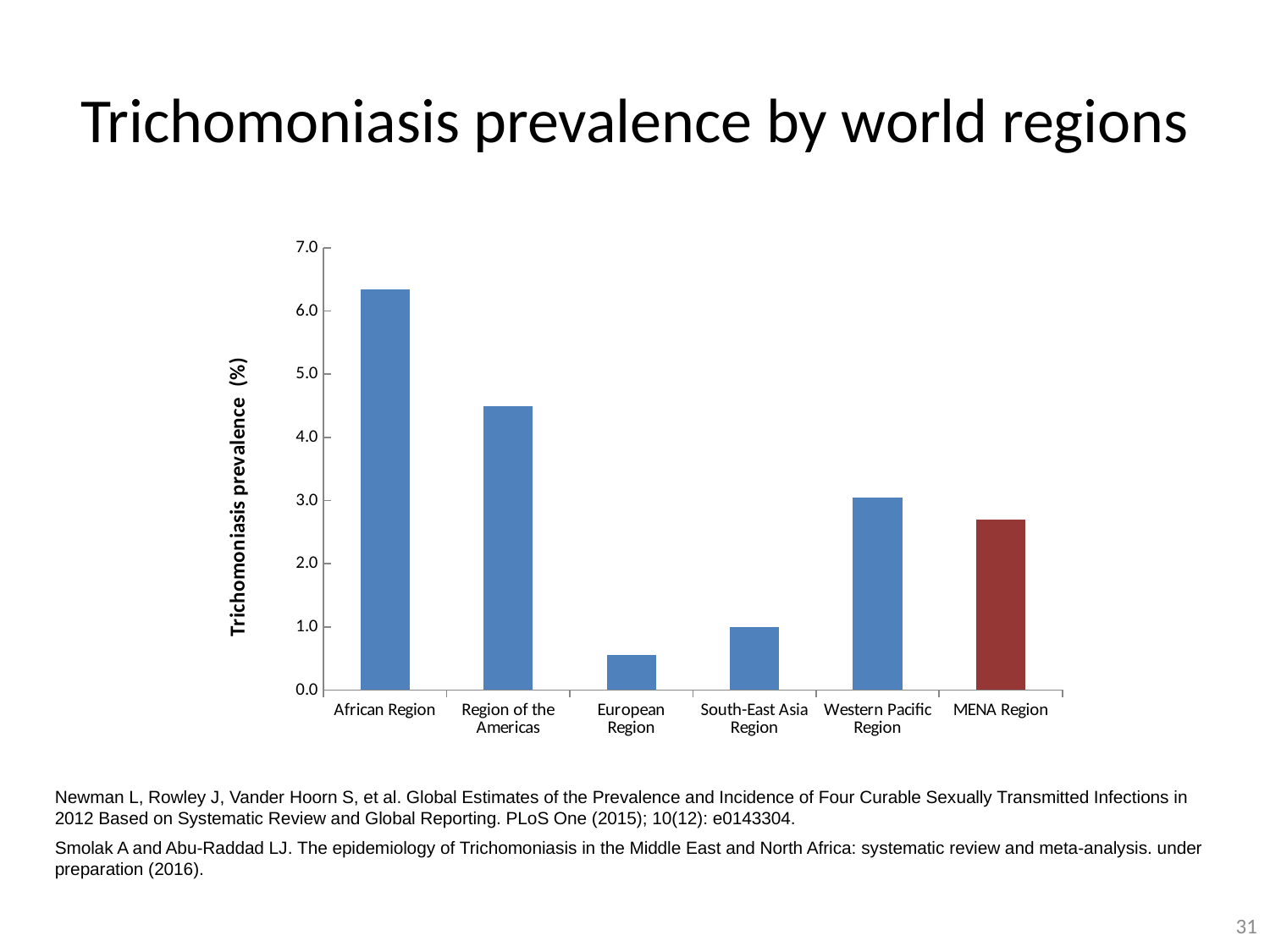
Which has a higher trichomoniasis prevalence, the Western Pacific Region or the MENA Region? Western Pacific Region Which has a higher trichomoniasis prevalence, the European Region or the South-East Asia Region? South-East Asia Region Which region has the highest trichomoniasis prevalence? African Region Is the value for the Western Pacific Region greater or less than 4.0? less Which region has the lowest trichomoniasis prevalence? European Region What kind of chart is shown on the slide? bar chart Which region's bar is coloured differently (red) from the others? MENA Region How many world regions are plotted in the chart? 6 Is the value for the African Region greater or less than 6.0? greater Is the value for the MENA Region greater or less than 3.0? less